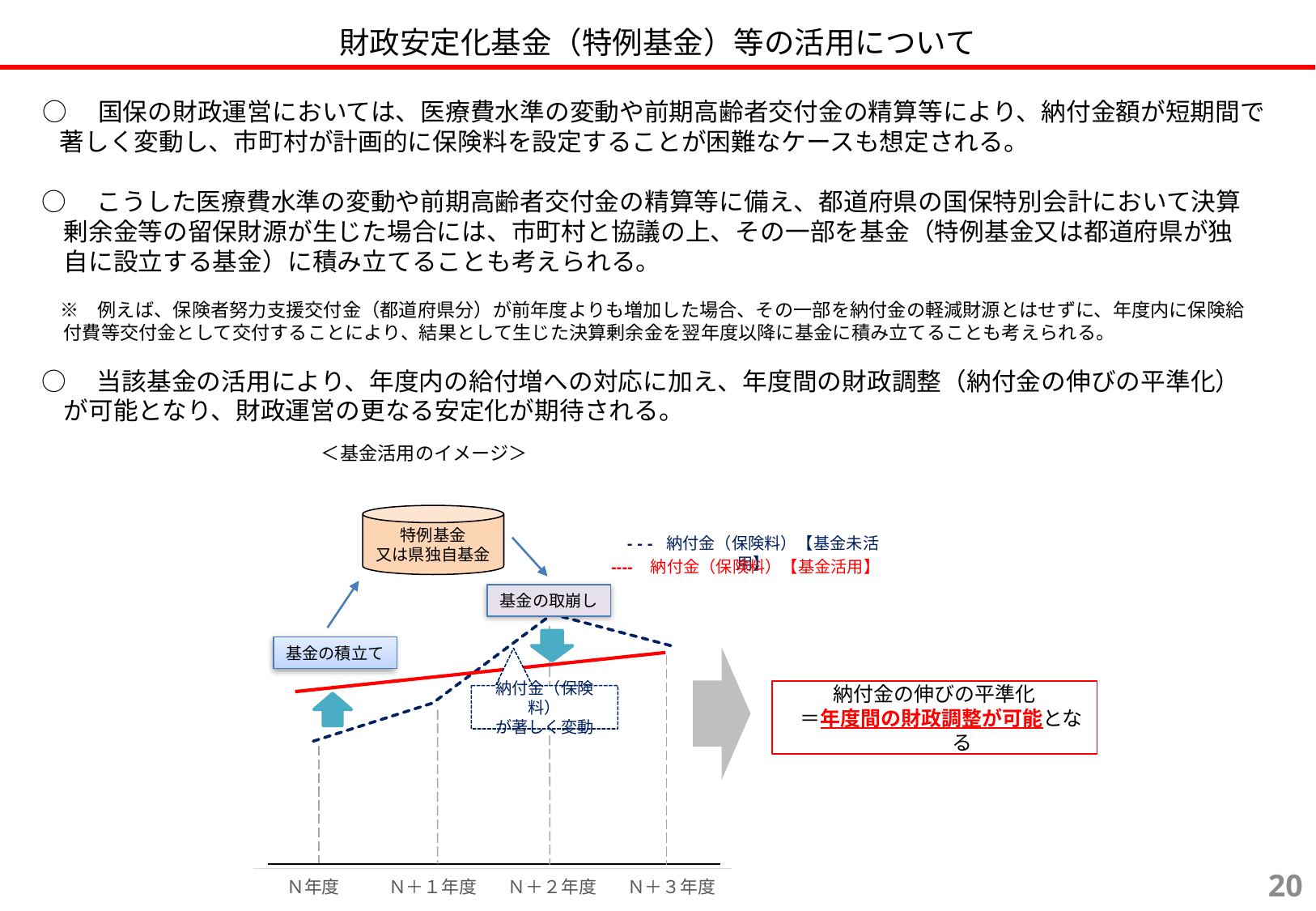
What is the label of the first category on the x axis of the 基金活用のイメージ chart? N年度 In the 基金活用のイメージ chart, at which fiscal year is the dashed line (納付金（保険料）【基金未活用】) at its lowest point? N年度 How many series does the legend of the 基金活用のイメージ chart list? 2 In the 基金活用のイメージ chart, does the red solid line (納付金（保険料）【基金活用】) rise or fall from N年度 to N＋３年度? rise In the 基金活用のイメージ chart, at N年度, which line is higher: the red solid line (基金活用) or the dashed line (基金未活用)? the red solid line (基金活用) What kind of chart is shown in the 基金活用のイメージ diagram? line chart How many fiscal-year categories are labelled on the x axis of the 基金活用のイメージ chart? 4 What is the label of the last category on the x axis of the 基金活用のイメージ chart? N＋３年度 In the 基金活用のイメージ chart, at which fiscal year does the dashed line (納付金（保険料）【基金未活用】) reach its highest point? N＋２年度 In the 基金活用のイメージ chart, at N＋２年度, which line is higher: the red solid line (基金活用) or the dashed line (基金未活用)? the dashed line (基金未活用)